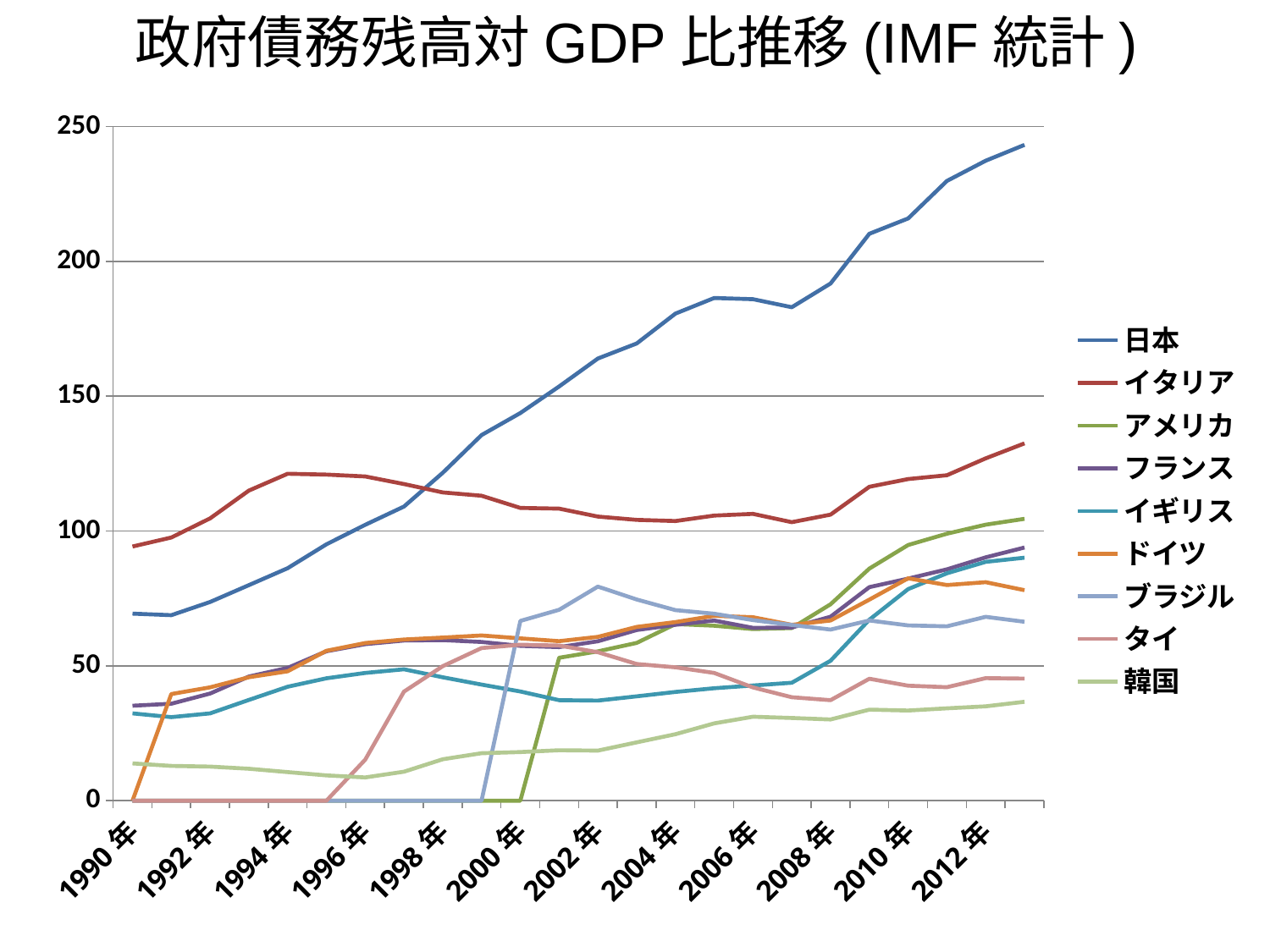
Does the line for 日本 generally rise or fall from 1990 to 2013? rise How many year labels are shown on the x axis? 12 Is the value for 日本 in 2012 greater or less than 200? greater What is the title of the chart? 政府債務残高対 GDP 比推移 (IMF 統計 ) In 2013, which is larger: the value for イタリア or the value for アメリカ? イタリア Is the value for ブラジル in 2002 greater or less than 50? greater Which series has the lowest value at the right end of the chart (2013)? 韓国 Is the value for 韓国 in 1996 greater or less than 50? less Which series has the highest value at the right end of the chart (2013)? 日本 How many series does the legend list? 9 What kind of chart is shown on the slide? line chart